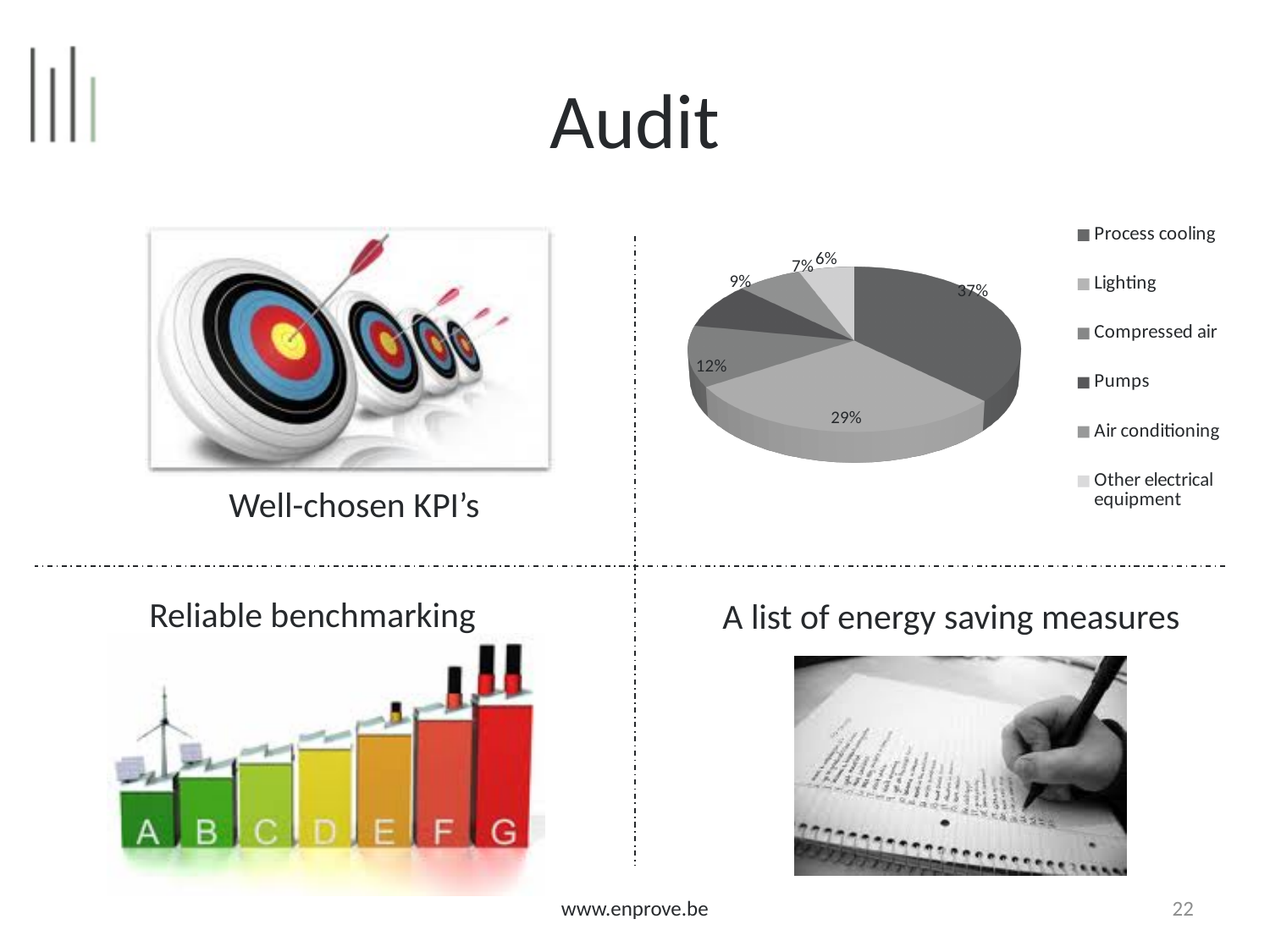
What type of chart is shown on the slide? pie chart What share of the pie chart does Other electrical equipment account for? 6% What share of the pie chart does Pumps account for? 9% Which category has the largest slice in the pie chart? Process cooling What share of the pie chart does Compressed air account for? 12% In the pie chart, what is the difference in percentage points between Process cooling and Lighting? 8 What share of the pie chart does Lighting account for? 29% What share of the pie chart does Process cooling account for? 37% What share of the pie chart does Air conditioning account for? 7% In the pie chart, which is larger: Compressed air or Pumps? Compressed air How many categories does the pie chart's legend list? 6 Which category has the smallest slice in the pie chart? Other electrical equipment